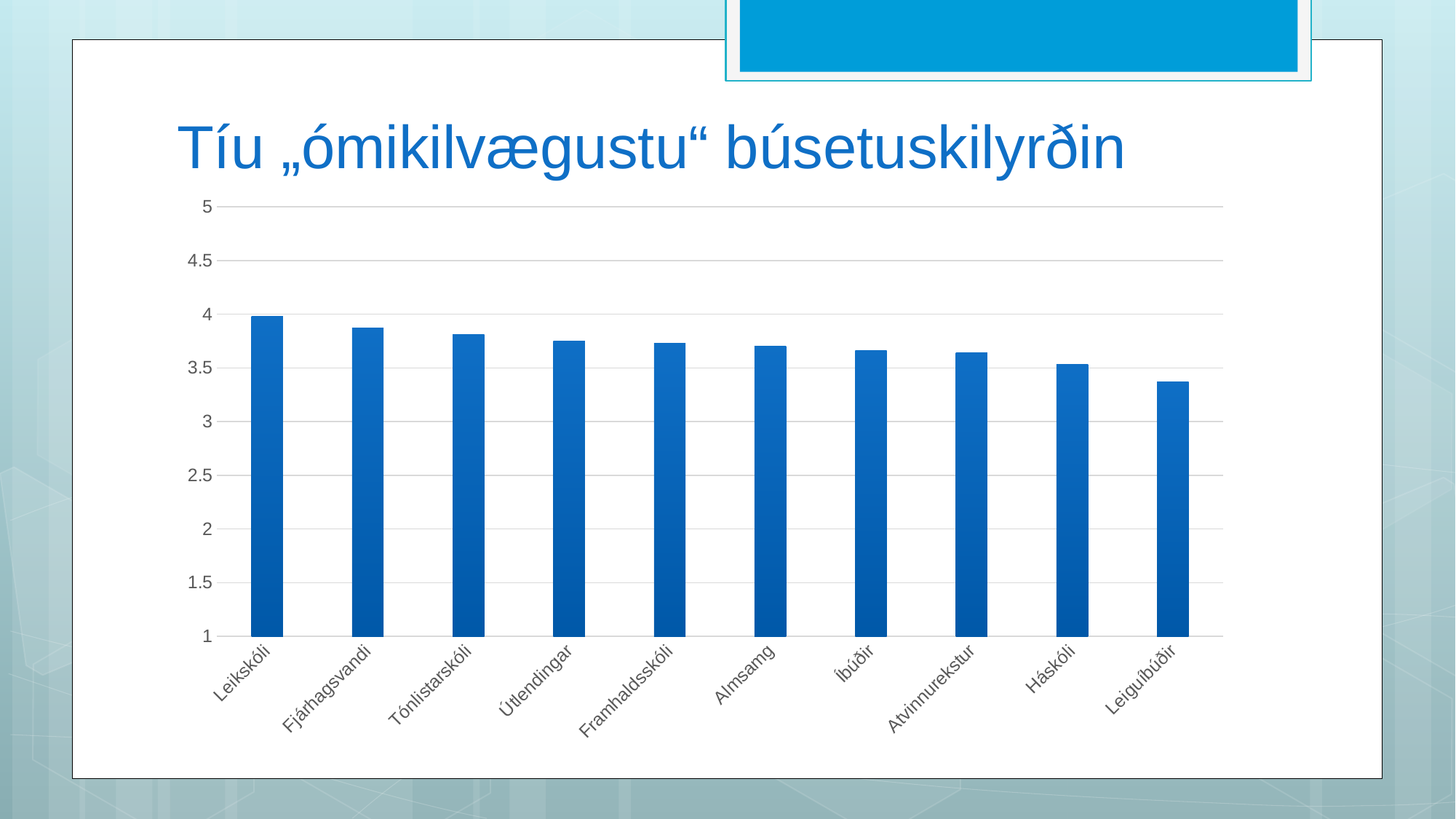
Which category has the highest bar in the chart? Leikskóli What kind of chart is shown on the slide? Bar chart Is the value for Fjárhagsvandi greater or less than 3.5? greater Which is larger, the value for Tónlistarskóli or the value for Atvinnurekstur? Tónlistarskóli How many categories are shown on the x axis of the chart? 10 Do the bar values rise or fall from left to right along the x axis? Fall Which is larger, the value for Leikskóli or the value for Háskóli? Leikskóli Which category has the lowest bar in the chart? Leiguíbúðir Is the value for Almsamg greater or less than 3? greater Is the value for Leiguíbúðir greater or less than 3.5? less What is the title of the slide containing the chart? Tíu „ómikilvægustu“ búsetuskilyrðin